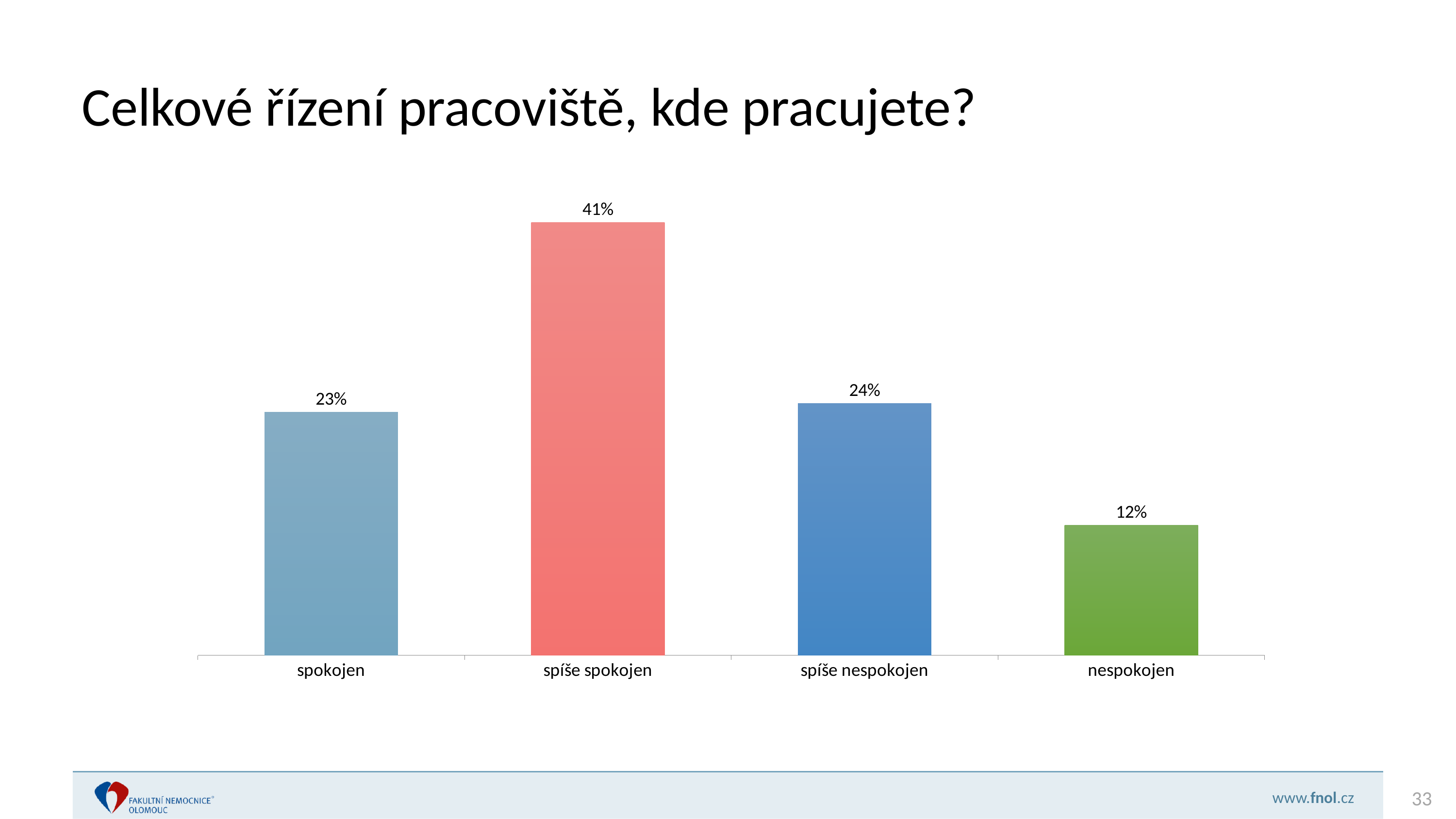
What is the title of the slide? Celkové řízení pracoviště, kde pracujete? What is the value for "spíše nespokojen"? 24% Which is larger, the value for "spokojen" or the value for "nespokojen"? spokojen What kind of chart is shown on the slide? bar chart Which category has the highest value? spíše spokojen What is the value for "spokojen"? 23% Which category has the lowest value? nespokojen How many categories are shown on the x axis? 4 What is the value for "spíše spokojen"? 41% What is the value for "nespokojen"? 12% What is the difference between the values for "spíše nespokojen" and "spokojen"? 1% What is the difference between the values for "spíše spokojen" and "nespokojen"? 29%